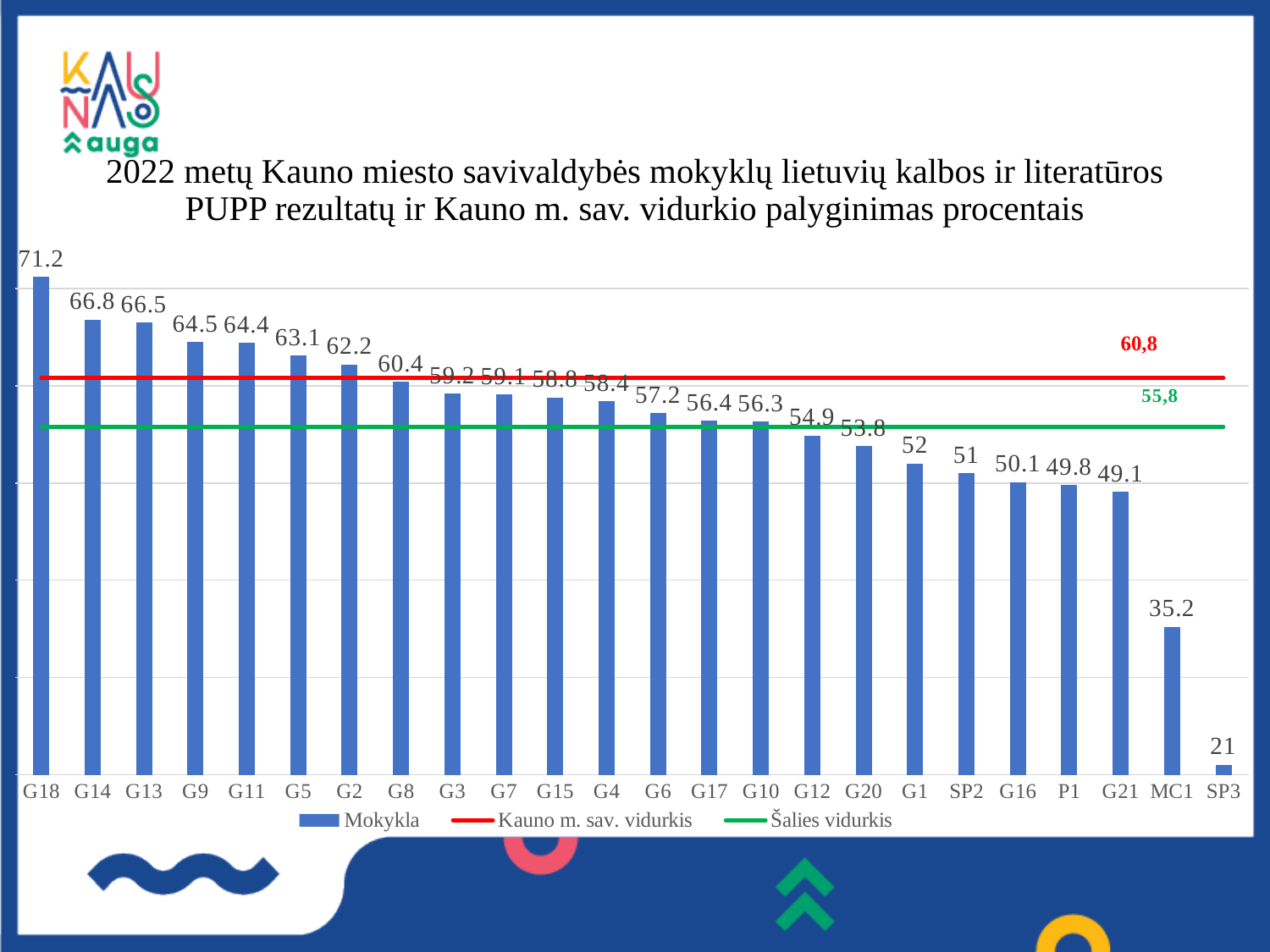
Which school has the lowest value? SP3 What is the value for G12? 54.9 How many series does the legend list? 3 Which school has the highest value? G18 What is the value for G18? 71.2 How many schools are shown on the x axis? 24 What value is shown for the red line labelled Kauno m. sav. vidurkis? 60,8 Which is larger, the value for G9 or the value for G1? G9 What is the value for MC1? 35.2 What is the difference between the values for G14 and G13? 0.3 What is the difference between the values for G18 and SP3? 50.2 What kind of chart is this? combination bar and line chart